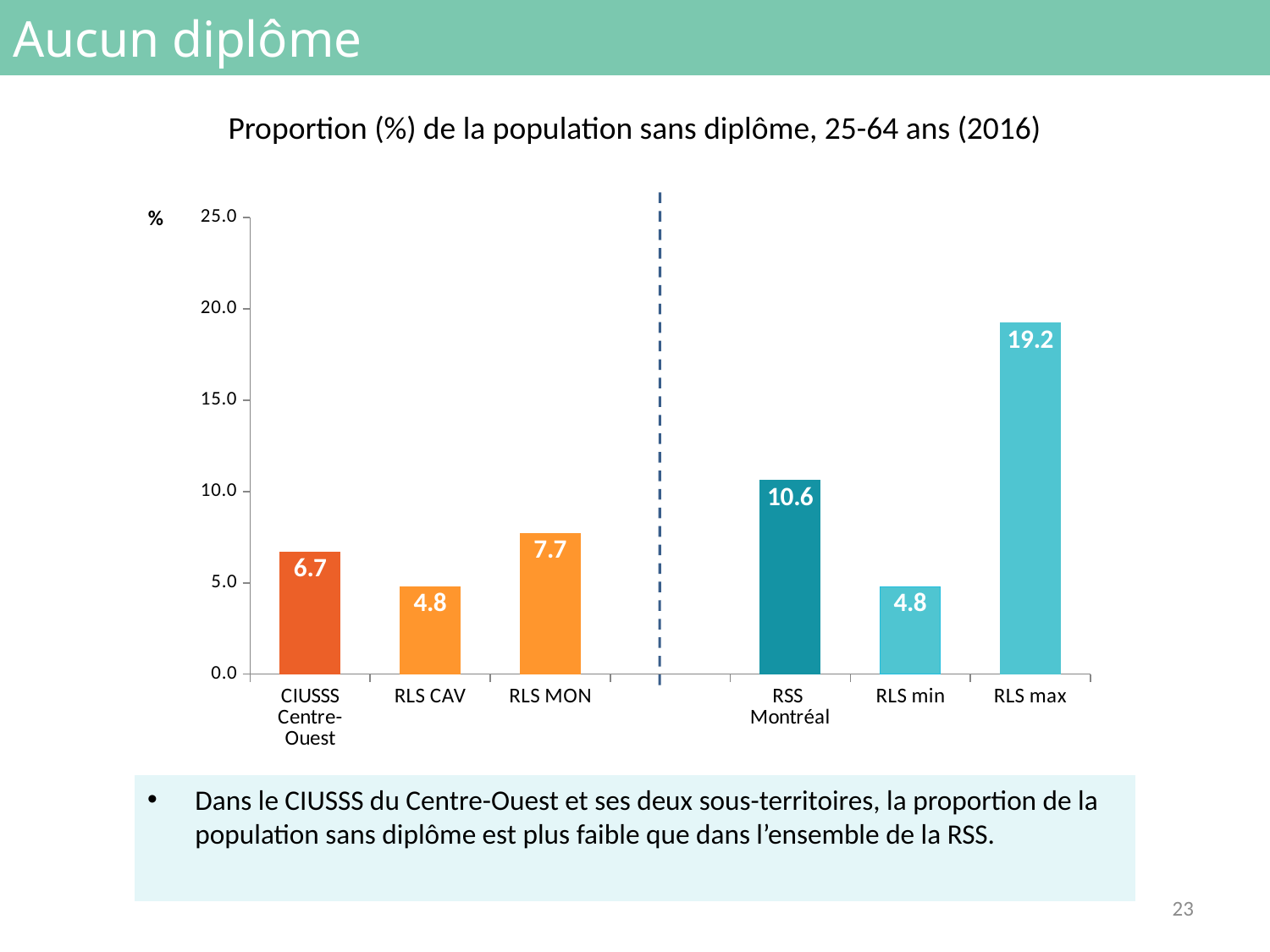
Is the value for RSS Montréal greater or less than 10.0? greater Which category has the highest value? RLS max What is the difference between RLS max and RLS min? 14.4 What is the value for RLS max? 19.2 What is the difference between RSS Montréal and CIUSSS Centre-Ouest? 3.9 What is the value for CIUSSS Centre-Ouest? 6.7 Which is larger, RLS MON or RLS CAV? RLS MON What is the value for RSS Montréal? 10.6 What is the value for RLS MON? 7.7 How many categories are shown on the chart? 6 What kind of chart is shown? bar chart What is the title of the chart? Proportion (%) de la population sans diplôme, 25-64 ans (2016)